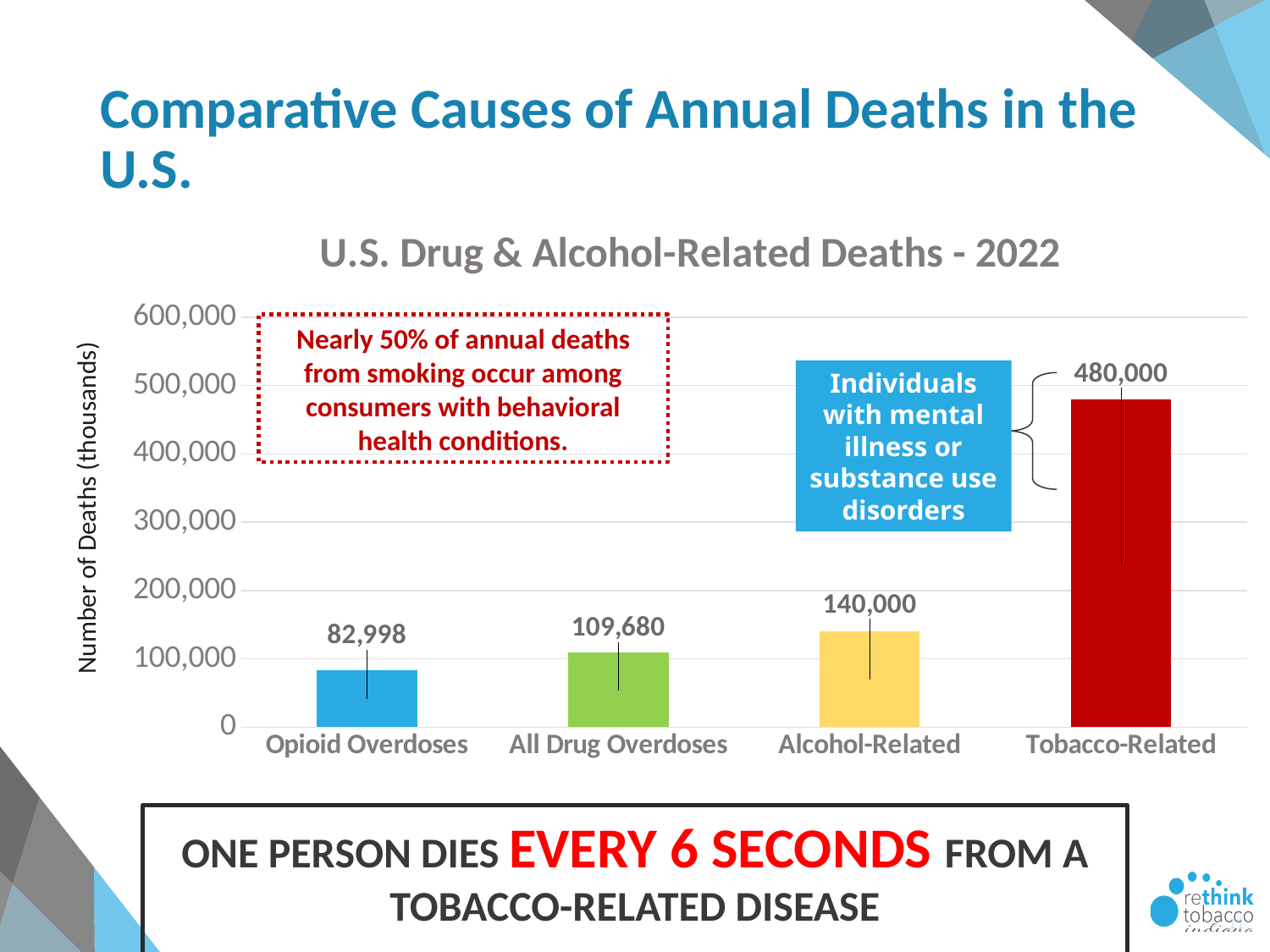
What is the difference between All Drug Overdoses and Opioid Overdoses? 26,682 What is the value for Tobacco-Related deaths? 480,000 Which category has the highest number of deaths? Tobacco-Related What is the value for Alcohol-Related deaths? 140,000 What is the value for Opioid Overdoses? 82,998 Which is larger, Alcohol-Related deaths or All Drug Overdoses? Alcohol-Related What is the title of the chart? U.S. Drug & Alcohol-Related Deaths - 2022 Which category has the lowest number of deaths? Opioid Overdoses What kind of chart is shown? Bar chart What is the difference between Tobacco-Related and Alcohol-Related deaths? 340,000 How many categories are shown on the chart? 4 What is the value for All Drug Overdoses? 109,680